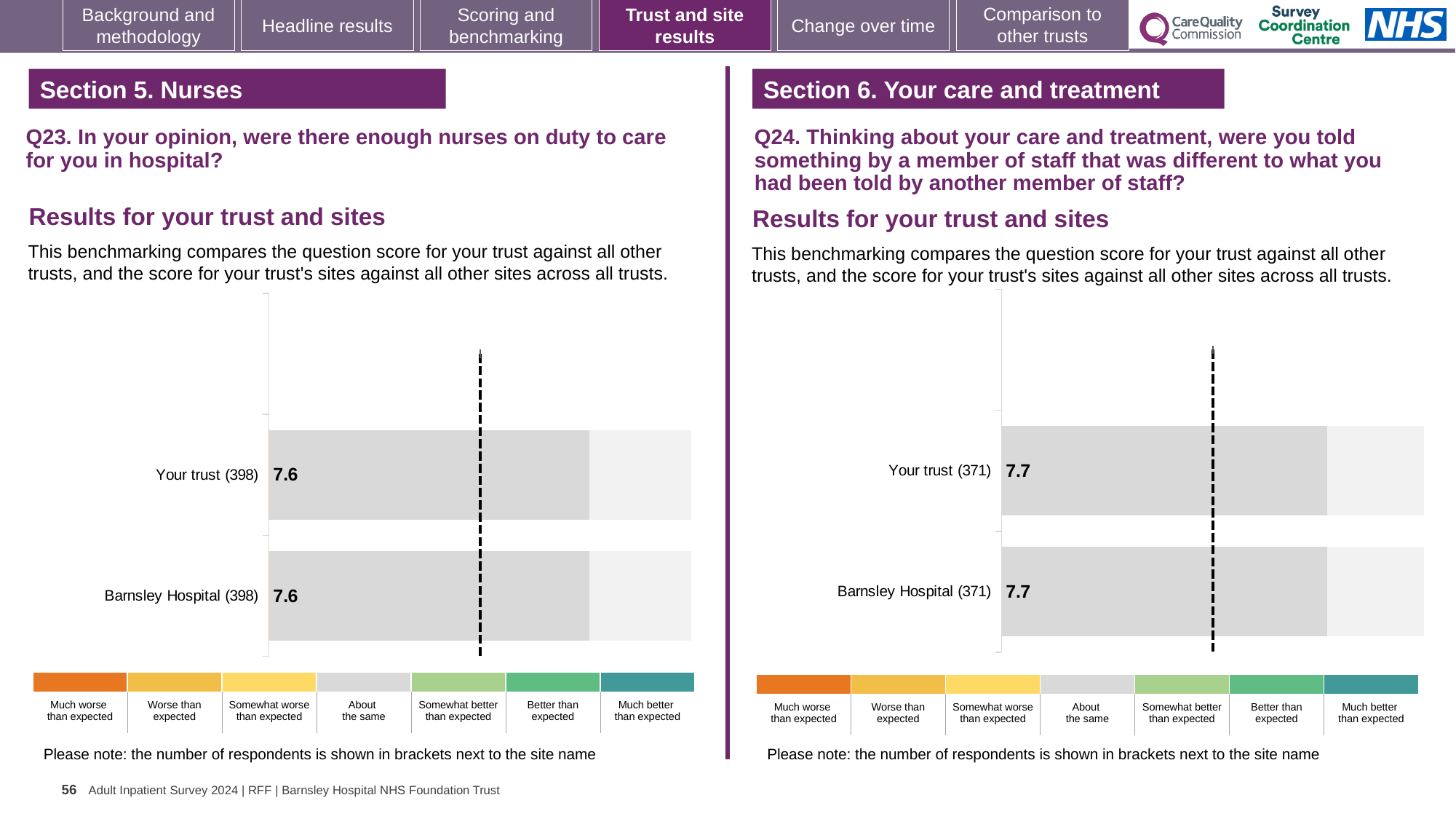
On the Q24 chart (right), what is the score for Your trust? 7.7 On the Q23 chart (left), what is the difference between the score for Your trust and the score for Barnsley Hospital? 0 What kind of chart is the Q23 chart (left)? Bar chart On the Q23 chart (left), what is the score for Your trust? 7.6 On the Q23 chart (left), how many respondents are shown in brackets for Barnsley Hospital? 398 On the Q24 chart (right), how many respondents are shown in brackets for Your trust? 371 On the Q24 chart (right), what is the score for Barnsley Hospital? 7.7 On the Q24 chart (right), which colour key category is shown in orange at the far left? Much worse than expected On the Q23 chart (left), what is the score for Barnsley Hospital? 7.6 How many bars are plotted on the Q24 chart (right)? 2 On the Q24 chart (right), is the score for Barnsley Hospital greater or less than the score for Your trust, or are they equal? Equal On the Q23 chart (left), how many categories does the colour key below the chart list? 7